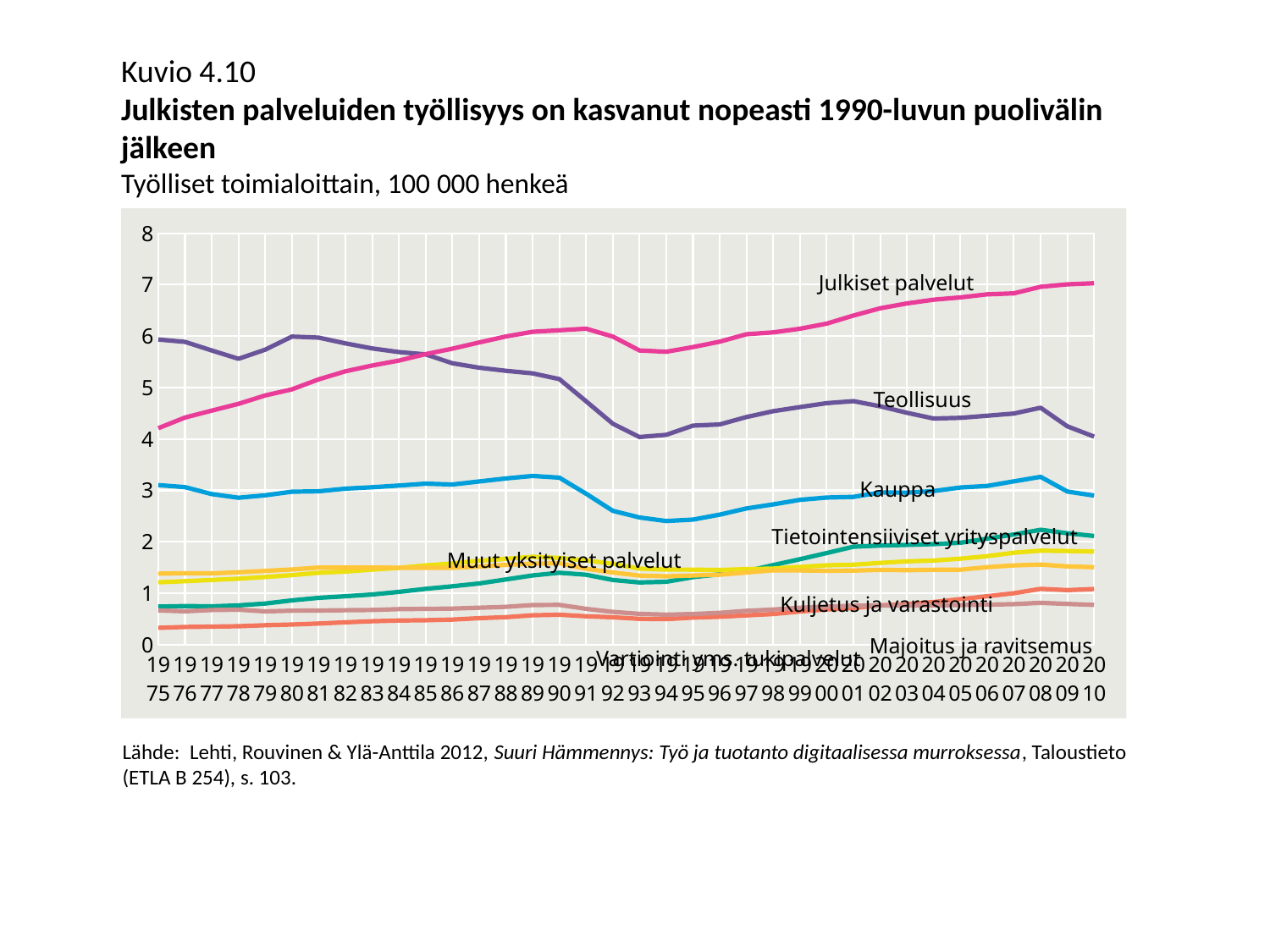
Which series has the highest value in 1975? Teollisuus What unit is stated in the chart's subtitle? 100 000 henkeä Which is larger in 2010, Julkiset palvelut or Teollisuus? Julkiset palvelut Which series has the highest value in 2010? Julkiset palvelut Which is larger in 1975, Julkiset palvelut or Teollisuus? Teollisuus Is the value for Kauppa in 1993 greater or less than 3? less Does the value for Teollisuus rise or fall from 1975 to 2010? Fall How many series (labelled lines) are plotted on the chart? 8 Is the value for Teollisuus in 2010 greater or less than 5? less What kind of chart is shown on the slide? Line chart Is the value for Julkiset palvelut in 2010 greater or less than 6? greater Does the value for Julkiset palvelut rise or fall from 1975 to 2010? Rise